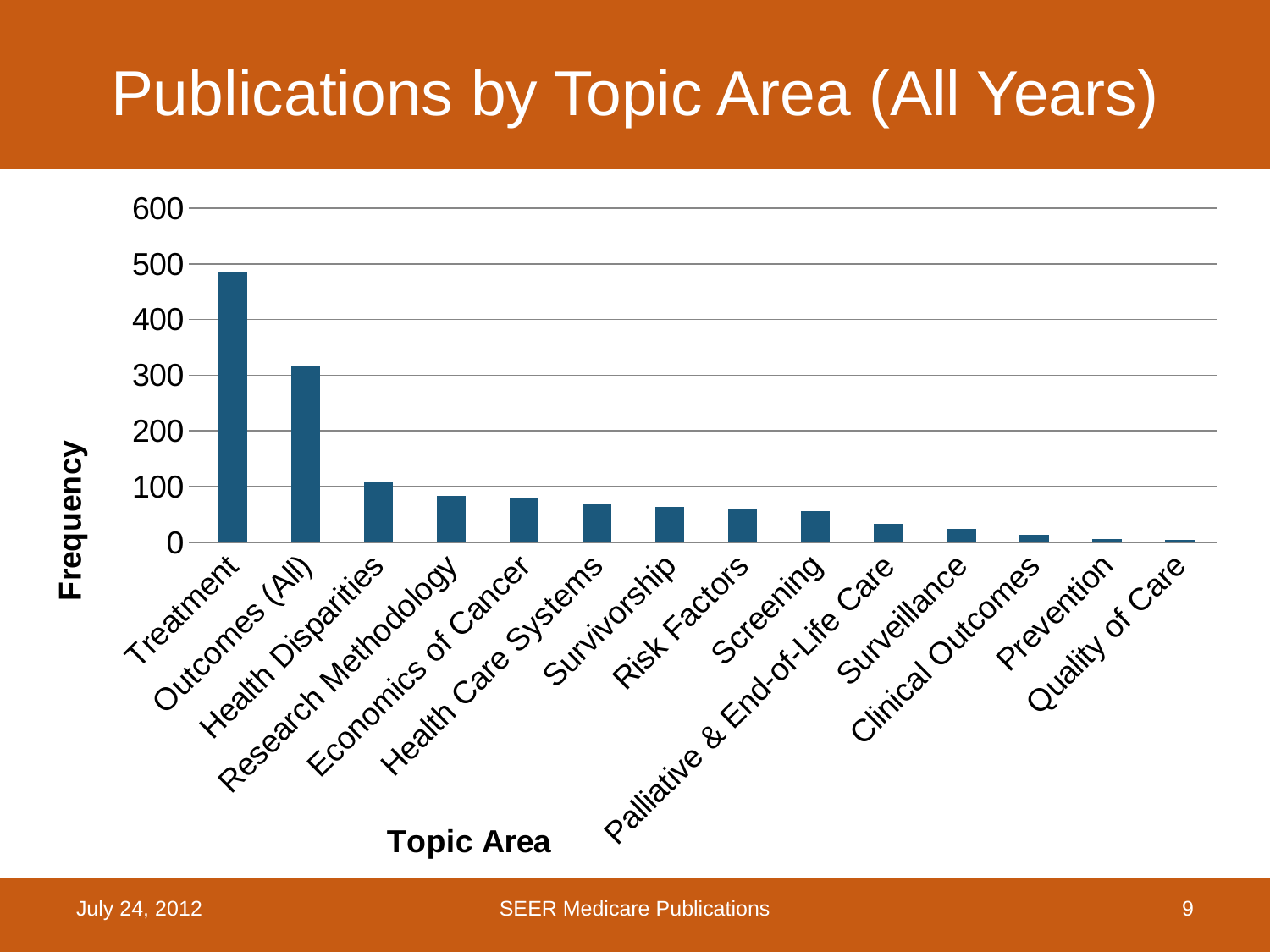
Do the frequencies rise or fall moving from left to right along the x axis? fall What is the title of the chart? Publications by Topic Area (All Years) Is the frequency for Treatment greater or less than 400? greater How many topic areas are shown on the x axis? 14 Is the frequency for Health Disparities greater or less than 200? less Which has a higher frequency, Health Disparities or Screening? Health Disparities What kind of chart is shown on the slide? bar chart Which topic area has the highest frequency? Treatment Is the frequency for Surveillance greater or less than 100? less Which has a higher frequency, Treatment or Outcomes (All)? Treatment